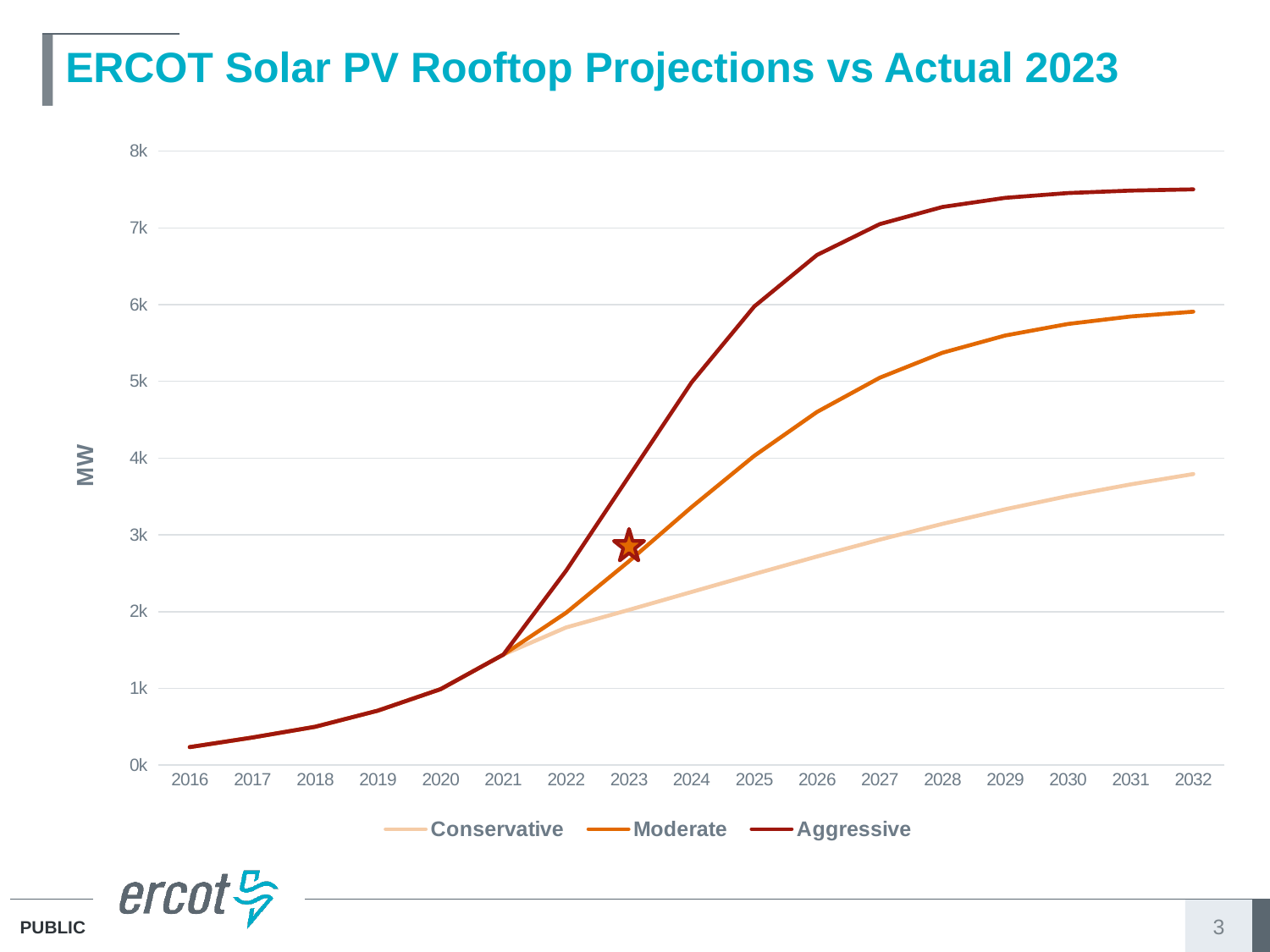
Is the Moderate value for 2032 greater or less than 5k? greater Is the Conservative value for 2032 greater or less than 4k? less Which series has the highest value in 2032? Aggressive Which series has the lowest value in 2032? Conservative How many years are shown along the x axis? 17 Is the Conservative value for 2026 greater or less than 3k? less What kind of chart is shown on the slide? Line chart What is the label on the y axis? MW In 2028, which is larger, the Aggressive value or the Moderate value? Aggressive Do the Aggressive series values rise or fall from 2016 to 2032? Rise How many series does the legend list? 3